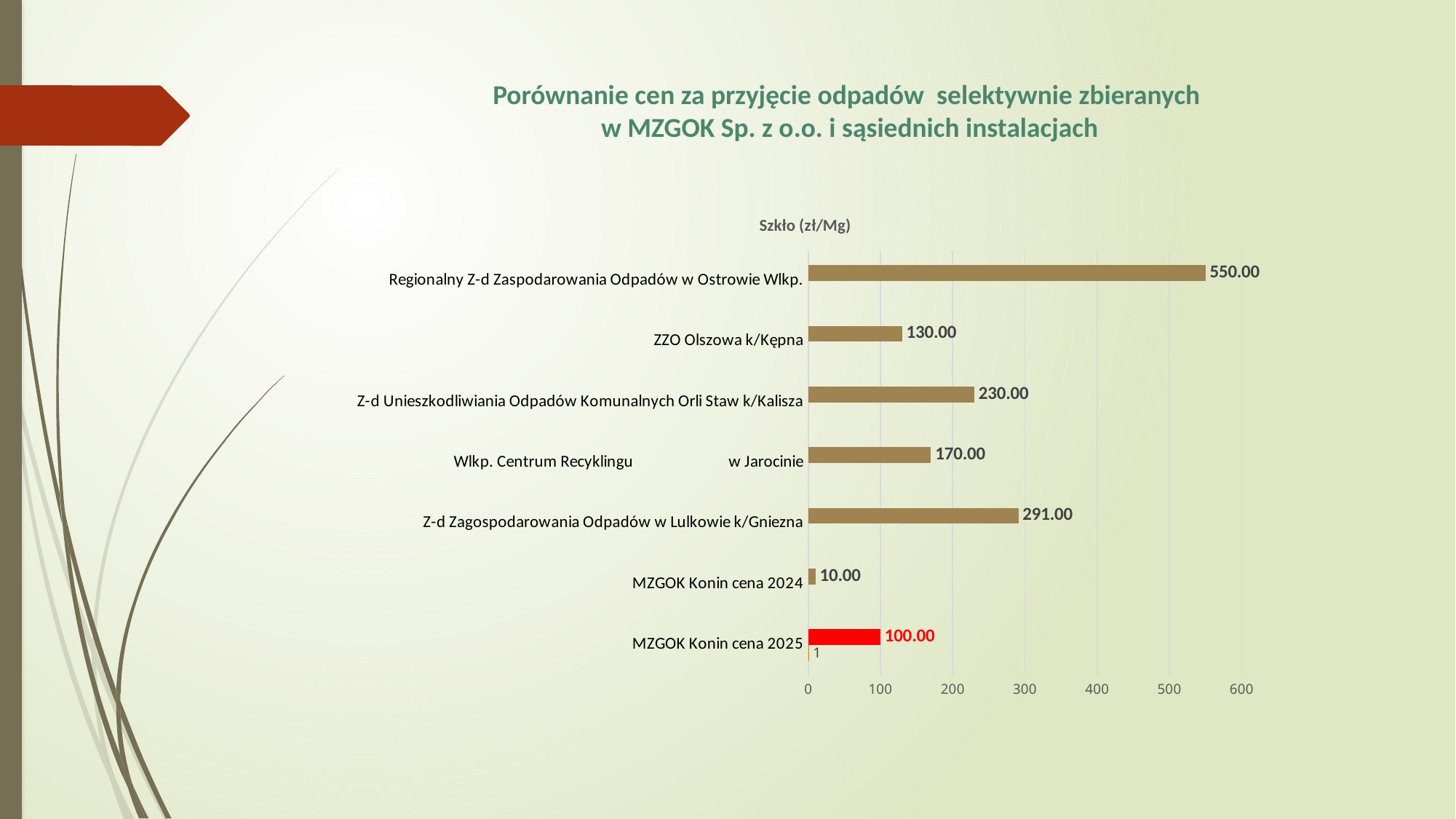
What is the value for Z-d Zagospodarowania Odpadów w Lulkowie k/Gniezna? 291.00 What is the chart's title? Szkło (zł/Mg) What is the difference between the values for MZGOK Konin cena 2025 and MZGOK Konin cena 2024? 90.00 What is the value for Regionalny Z-d Zaspodarowania Odpadów w Ostrowie Wlkp.? 550.00 What is the value for ZZO Olszowa k/Kępna? 130.00 Is the value for Z-d Zagospodarowania Odpadów w Lulkowie k/Gniezna greater or less than 200? greater Which category has the highest value? Regionalny Z-d Zaspodarowania Odpadów w Ostrowie Wlkp. What is the value for MZGOK Konin cena 2025? 100.00 Which is larger: the value for Z-d Unieszkodliwiania Odpadów Komunalnych Orli Staw k/Kalisza or the value for Wlkp. Centrum Recyklingu w Jarocinie? Z-d Unieszkodliwiania Odpadów Komunalnych Orli Staw k/Kalisza How many categories are shown in the chart? 7 What kind of chart is shown on the slide? bar chart Which category has the lowest value? MZGOK Konin cena 2024